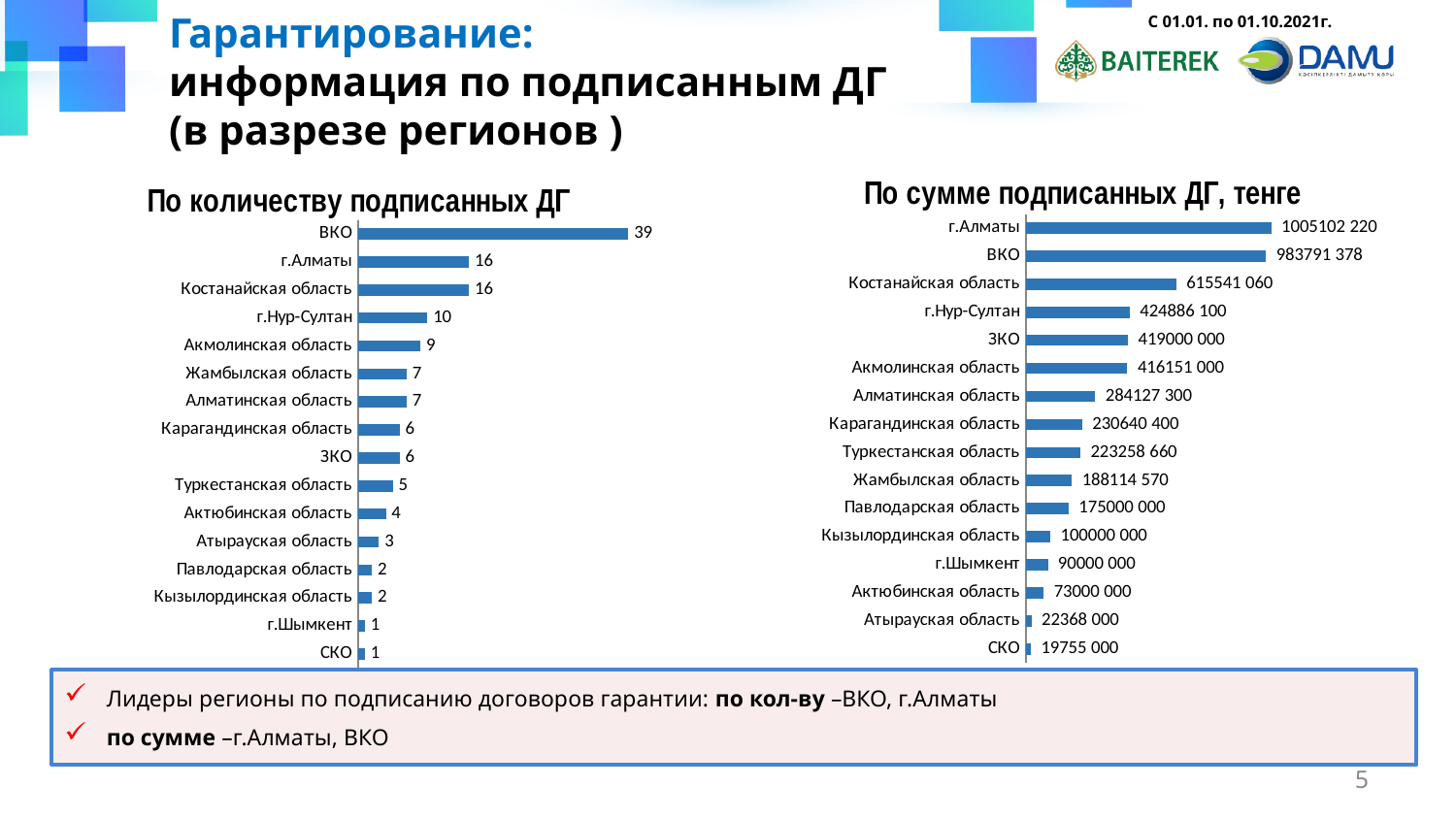
In the chart 'По сумме подписанных ДГ, тенге', what is the difference between the values for г.Шымкент and Актюбинская область? 17000 000 In the chart 'По количеству подписанных ДГ', how many regions are shown? 16 In the chart 'По количеству подписанных ДГ', which region has the highest value? ВКО In the chart 'По количеству подписанных ДГ', what is the value for ВКО? 39 In the chart 'По количеству подписанных ДГ', what is the difference between the values for ВКО and г.Нур-Султан? 29 In the chart 'По сумме подписанных ДГ, тенге', which region has the lowest value? СКО In the chart 'По сумме подписанных ДГ, тенге', which is larger, the value for Костанайская область or г.Нур-Султан? Костанайская область In the chart 'По количеству подписанных ДГ', what is the value for Акмолинская область? 9 What type of chart is 'По сумме подписанных ДГ, тенге'? Bar chart In the chart 'По сумме подписанных ДГ, тенге', what is the value for Павлодарская область? 175000 000 In the chart 'По количеству подписанных ДГ', which is larger, the value for Туркестанская область or Атырауская область? Туркестанская область In the chart 'По сумме подписанных ДГ, тенге', what is the value for г.Алматы? 1005102 220